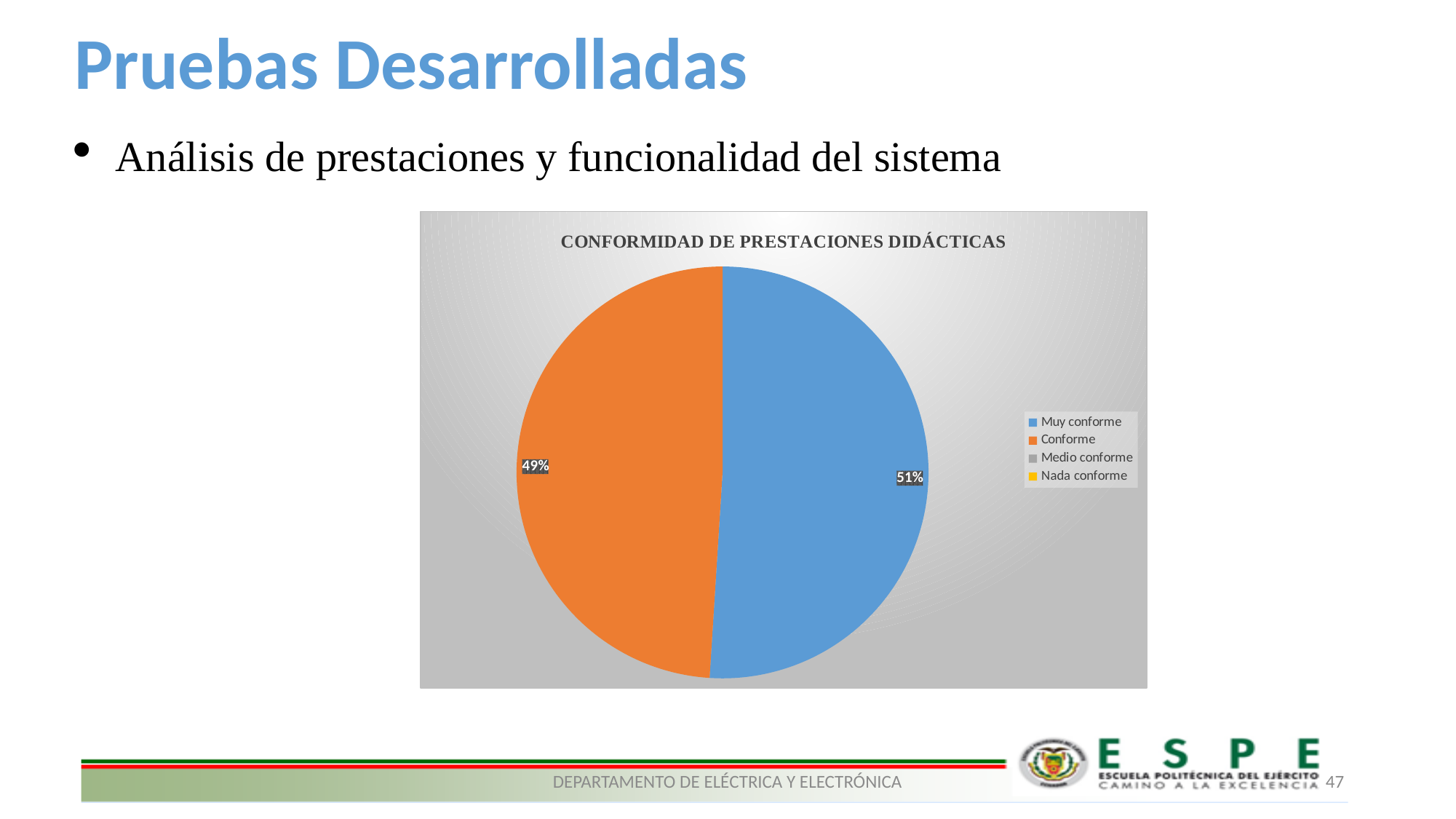
Which is larger, the slice for Muy conforme or the slice for Conforme? Muy conforme What percentage of the pie is labelled for Conforme? 49% What kind of chart is shown on the slide? Pie chart What is the difference in percentage points between the Muy conforme slice and the Conforme slice? 2 percentage points What is the title of the chart? CONFORMIDAD DE PRESTACIONES DIDÁCTICAS What percentage of the pie is labelled for Muy conforme? 51% What colour represents Conforme in the pie chart? Orange How many slices with printed percentage labels are visible in the pie? 2 Which category has the largest slice of the pie? Muy conforme What is the combined share of the Muy conforme and Conforme slices? 100% How many entries does the chart legend list? 4